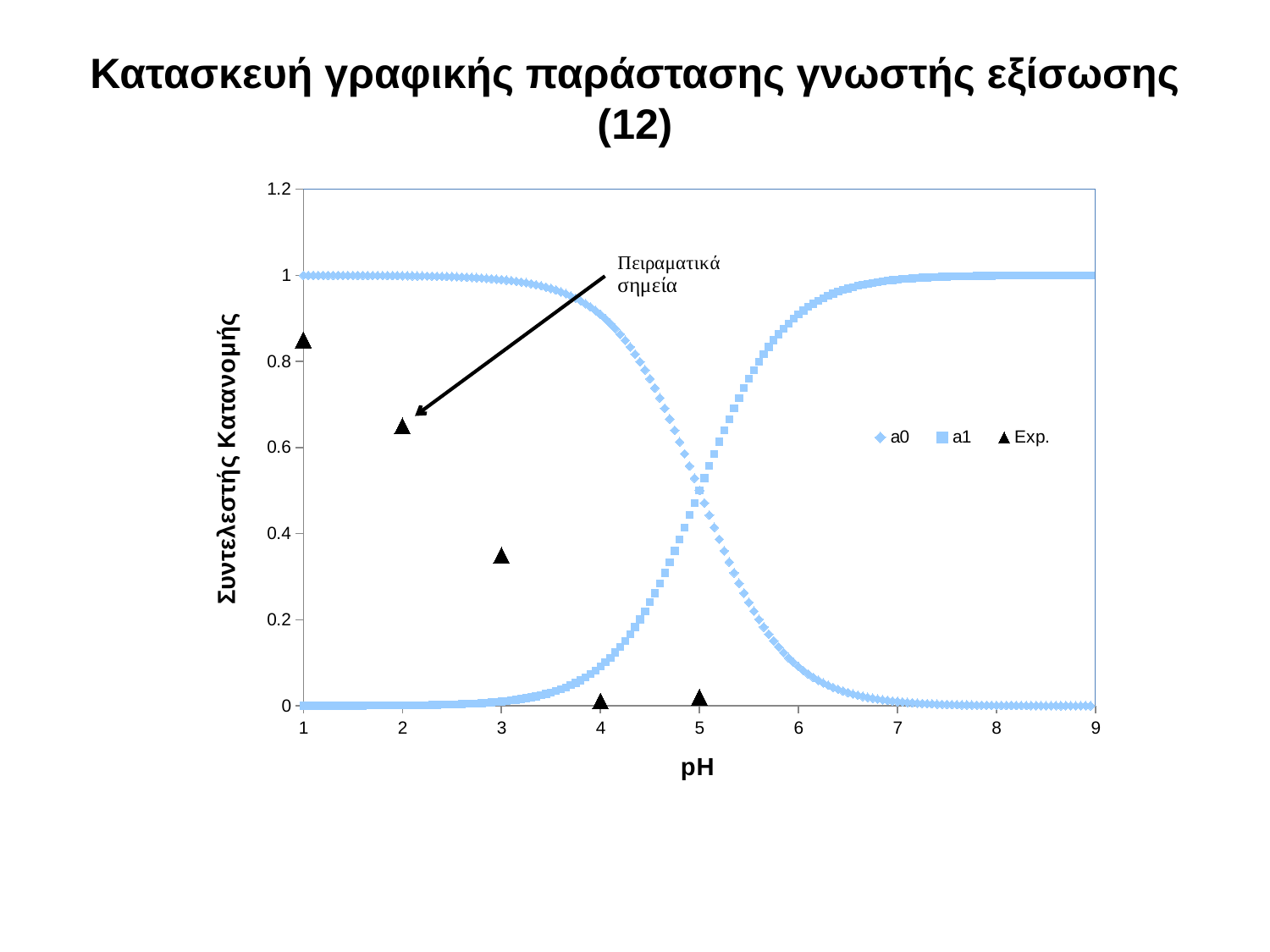
How many Exp. data points are plotted on the chart? 5 How many series does the chart legend list? 3 At pH 3, which series has the larger value, a0 or a1? a0 What are the series names listed in the chart legend? a0, a1, Exp. What is the title of the x axis of the chart? pH At which pH value is the highest Exp. point plotted? 1 What kind of chart is shown on the slide? scatter chart Does the a1 series rise or fall as pH increases along the x axis? rise Does the a0 series rise or fall as pH increases along the x axis? fall Is the Exp. value at pH 2 greater or less than 0.6? greater Is the Exp. value at pH 3 greater or less than 0.4? less Is the Exp. value at pH 1 greater or less than 0.8? greater